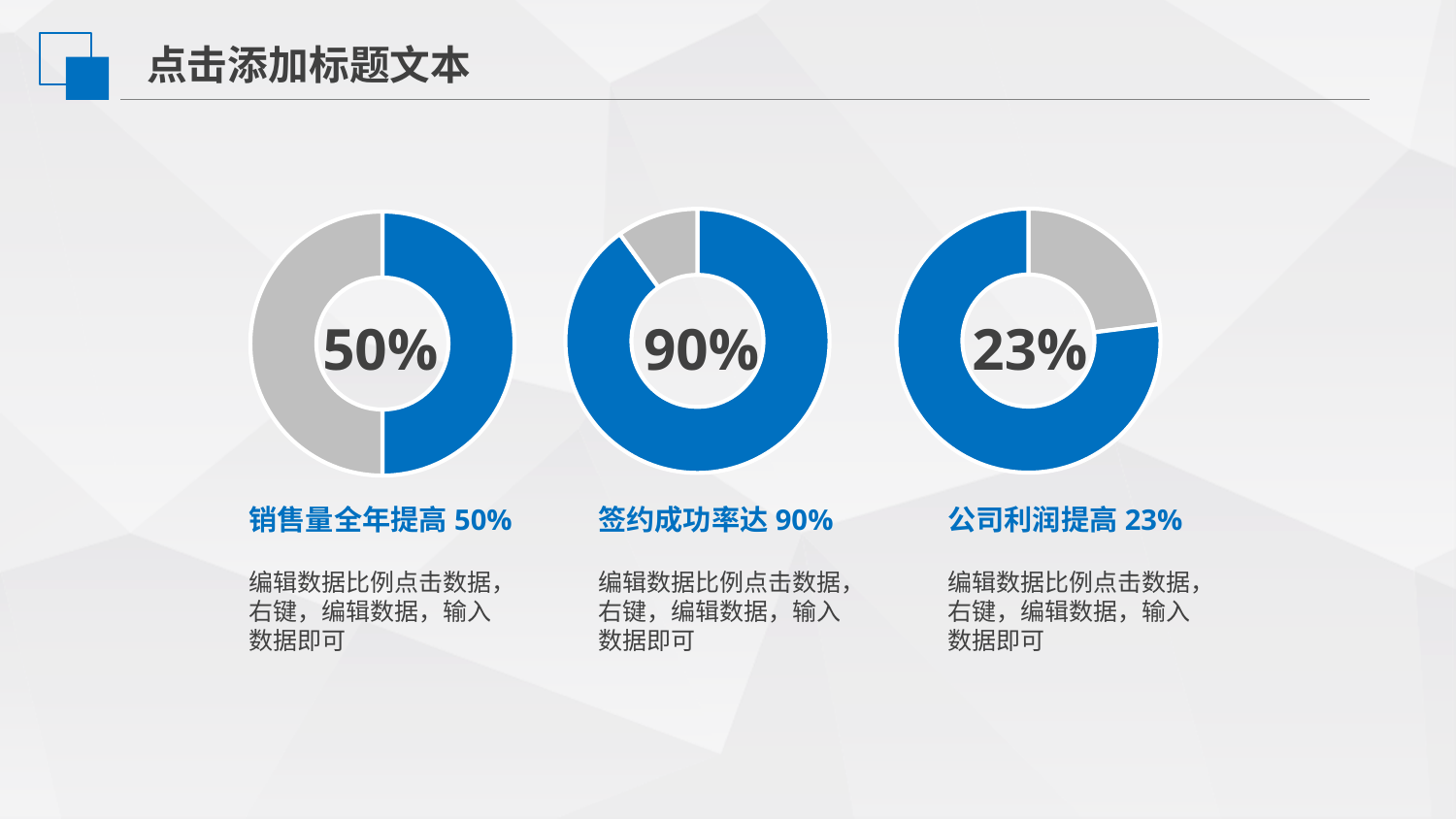
What is the difference between the percentage in the middle chart and the percentage in the left chart? 40 percentage points What is the caption printed below the middle doughnut chart? 签约成功率达 90% Which of the three doughnut charts shows the lowest percentage? The right chart (公司利润提高 23%) In the left doughnut chart, what share of the ring is filled in blue? 50% What colour is used for the highlighted segment in each doughnut chart? Blue What percentage is shown in the centre of the middle doughnut chart (签约成功率达)? 90% Which is larger: the percentage in the left chart or the percentage in the right chart? The left chart (50%) What percentage is shown in the centre of the left doughnut chart (销售量全年提高)? 50% What percentage is shown in the centre of the right doughnut chart (公司利润提高)? 23% What kind of charts are shown on the slide? Doughnut charts Which of the three doughnut charts shows the highest percentage? The middle chart (签约成功率达 90%) How many doughnut charts are on the slide? 3